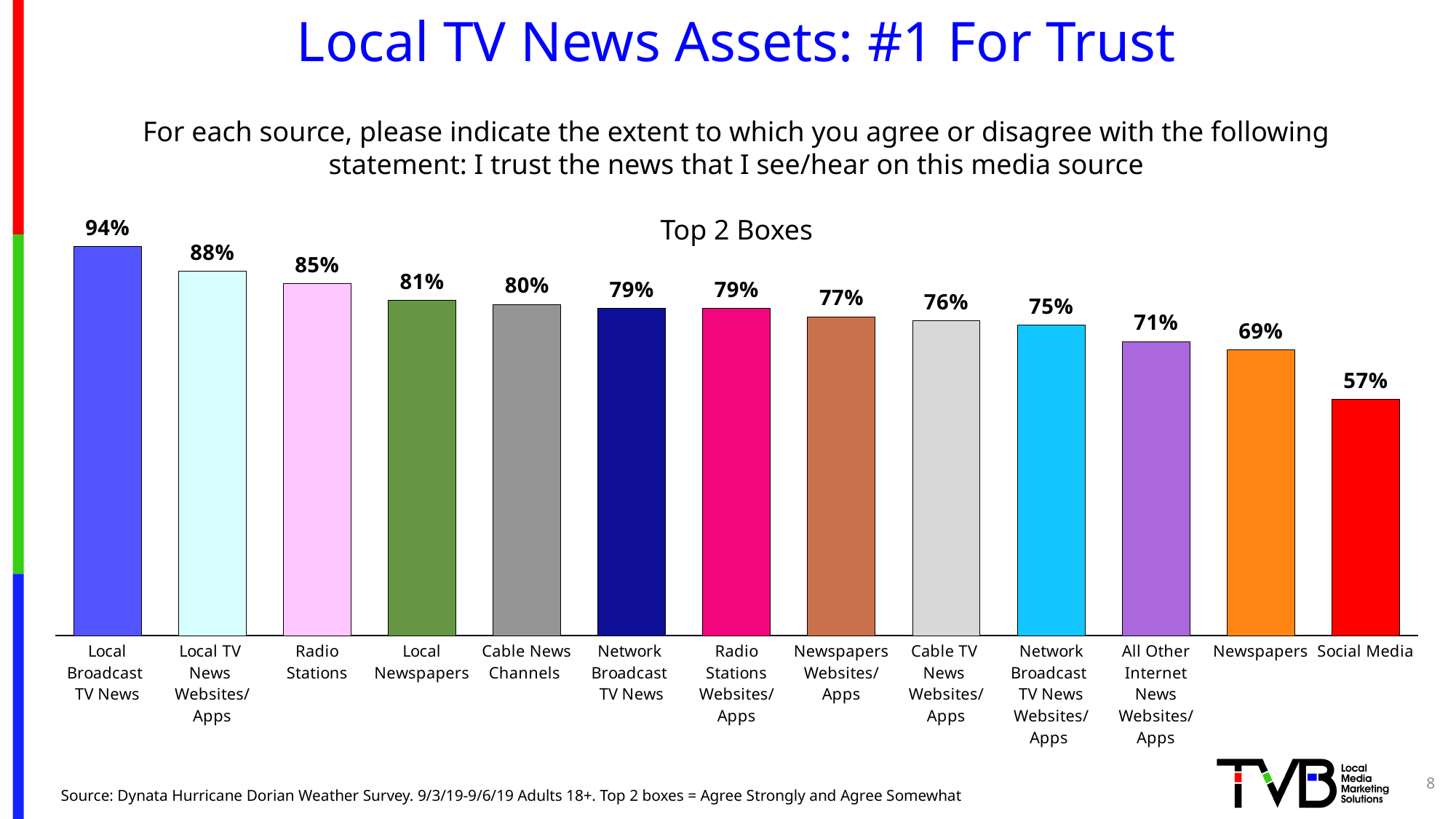
Which category has the highest value? Local Broadcast TV News What is the difference between Local TV News Websites/Apps and Newspapers? 19% Which category has the lowest value? Social Media What is the difference between Local Broadcast TV News and Social Media? 37% Which is larger, Radio Stations or Cable News Channels? Radio Stations What is the value for Radio Stations Websites/Apps? 79% How many categories are shown in the chart? 13 What kind of chart is shown on the slide? bar chart What is the value for Local Broadcast TV News? 94% What is the title shown above the chart's bars? Top 2 Boxes What is the value for Social Media? 57% What is the value for All Other Internet News Websites/Apps? 71%